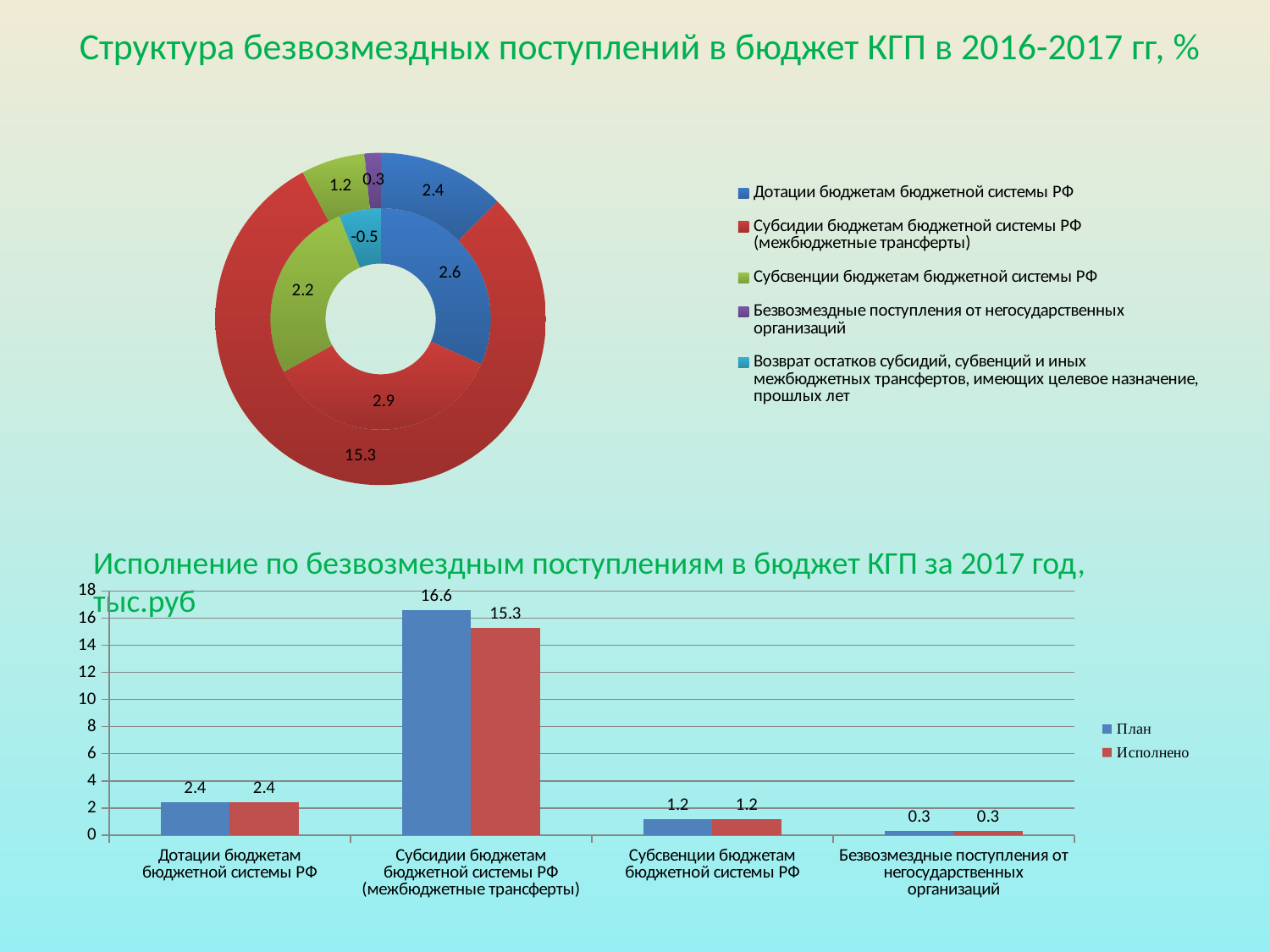
What kind of chart is the bottom chart on the slide? Bar chart In the bottom bar chart, what is the difference between the План and Исполнено values for Субсидии бюджетам бюджетной системы РФ (межбюджетные трансферты)? 1.3 In the top doughnut chart, how many entries does the legend list? 5 In the top doughnut chart, what value is labelled on the outer ring for Субсидии бюджетам бюджетной системы РФ (межбюджетные трансферты)? 15.3 In the bottom bar chart, what is the План value for Субсидии бюджетам бюджетной системы РФ (межбюджетные трансферты)? 16.6 In the bottom bar chart, what is the План value for Дотации бюджетам бюджетной системы РФ? 2.4 In the bottom bar chart, how many series does the legend list? 2 In the bottom bar chart, which category has the highest Исполнено value? Субсидии бюджетам бюджетной системы РФ (межбюджетные трансферты) What kind of chart is the top chart on the slide? Doughnut chart In the bottom bar chart, which category has the lowest План value? Безвозмездные поступления от негосударственных организаций In the bottom bar chart, what is the Исполнено value for Субсидии бюджетам бюджетной системы РФ (межбюджетные трансферты)? 15.3 In the bottom bar chart, how many categories are shown on the x axis? 4